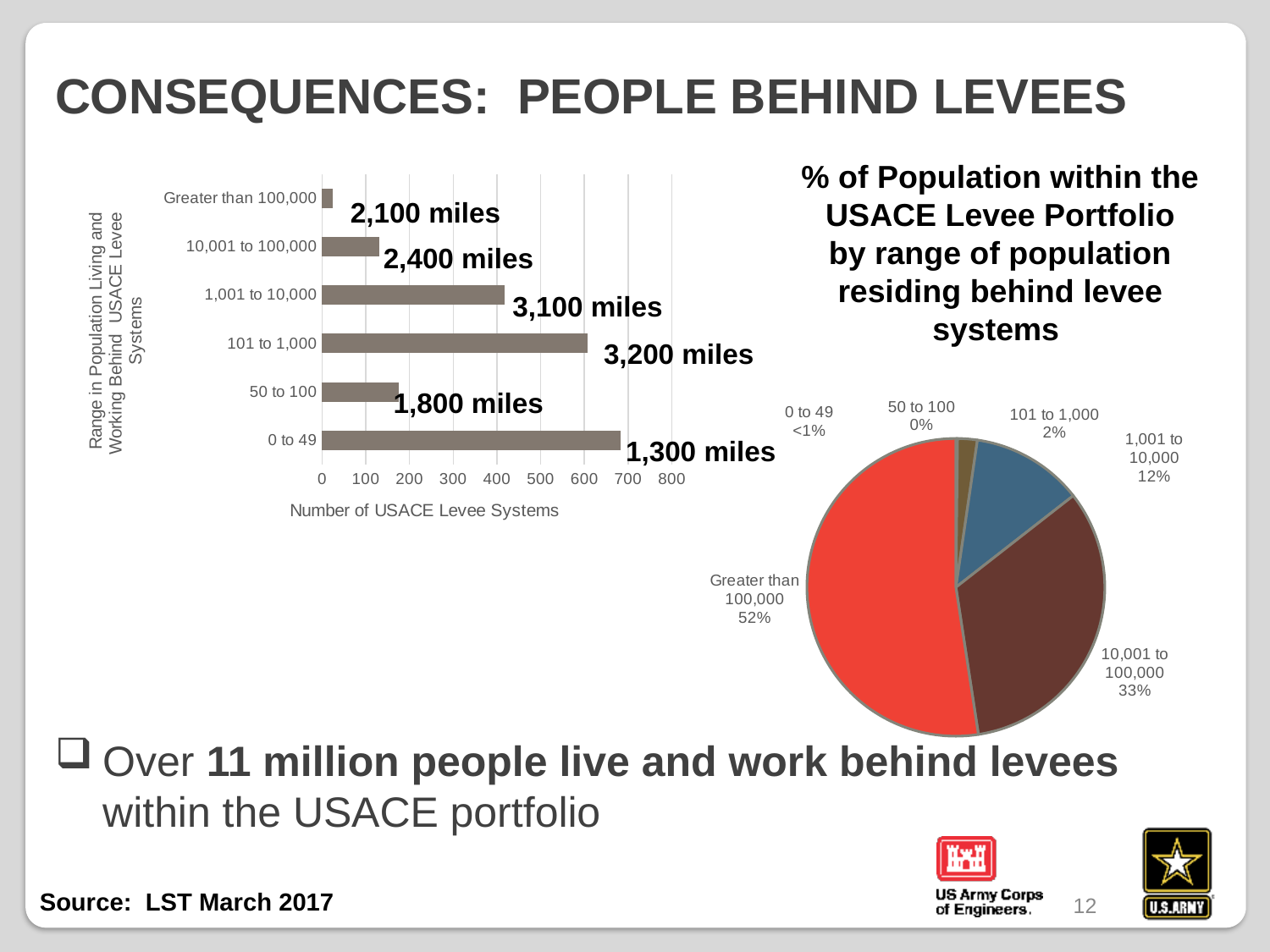
In the pie chart, what share of the population is in the 'Greater than 100,000' range? 52% What kind of chart is the chart on the left showing the Number of USACE Levee Systems? Bar chart In the pie chart, what percentage is shown for the '10,001 to 100,000' range? 33% In the pie chart, which population range has the largest share? Greater than 100,000 In the pie chart, what percentage is shown for the '1,001 to 10,000' range? 12% In the bar chart on the left, which has more levee systems: '1,001 to 10,000' or '50 to 100'? 1,001 to 10,000 In the bar chart on the left, which population range has the highest number of USACE levee systems? 0 to 49 In the pie chart, how many percentage points larger is the 'Greater than 100,000' share than the '10,001 to 100,000' share? 19 percentage points In the bar chart on the left, which population range has the lowest number of USACE levee systems? Greater than 100,000 In the bar chart on the left, is the number of levee systems for '101 to 1,000' greater or less than 500? greater In the bar chart on the left, is the number of levee systems for '10,001 to 100,000' greater or less than 200? less How many slices (population ranges) does the pie chart show? 6